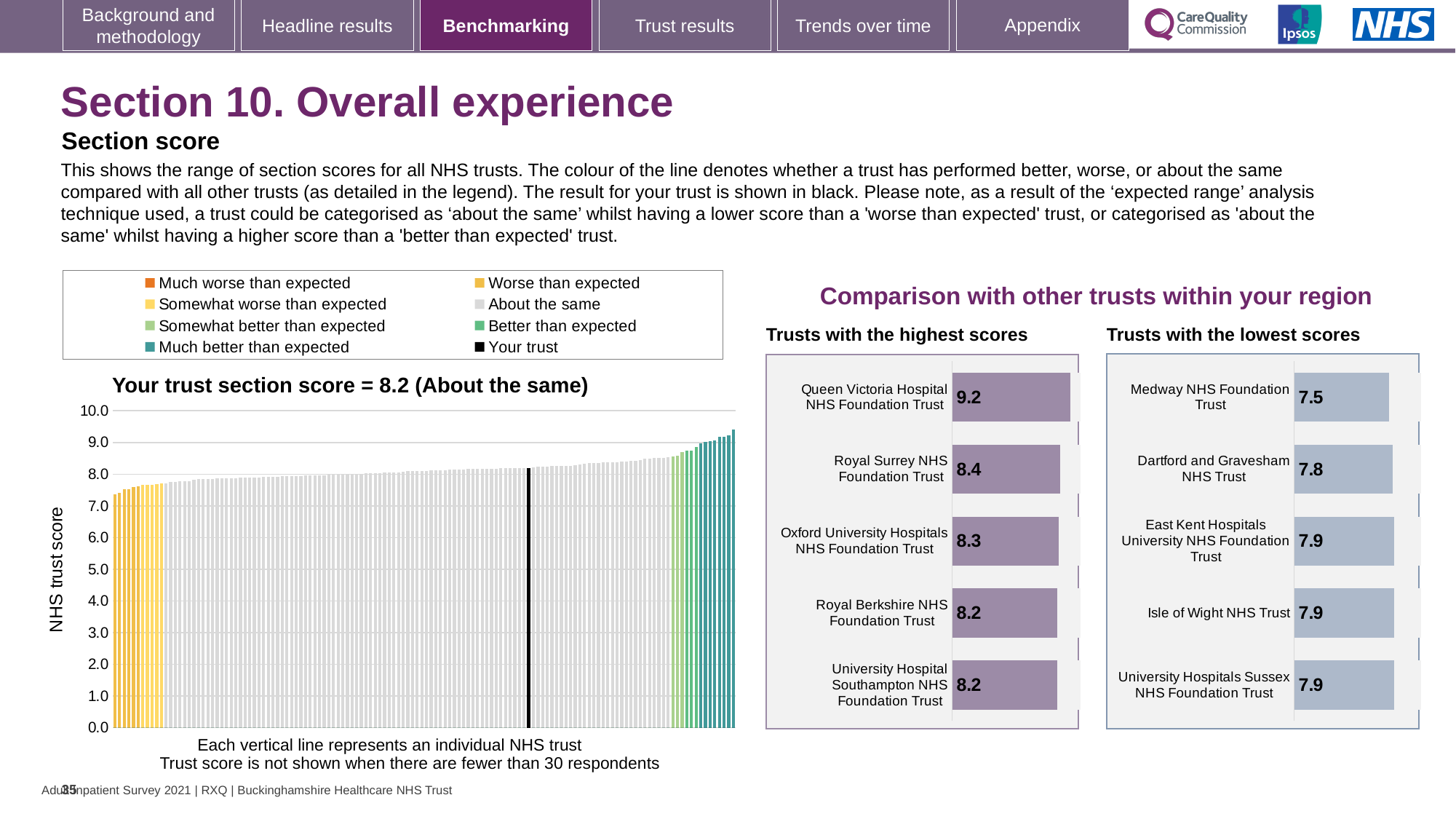
In the 'Trusts with the highest scores' chart, what is the score for Queen Victoria Hospital NHS Foundation Trust? 9.2 What kind of chart is the main chart on the left showing NHS trust scores? Bar chart How many entries does the legend above the main chart on the left list? 8 In the 'Trusts with the lowest scores' chart, which trust has the lowest score? Medway NHS Foundation Trust In the main chart on the left, what is the section score for your trust? 8.2 In the 'Trusts with the highest scores' chart, which trust has the highest score? Queen Victoria Hospital NHS Foundation Trust In the 'Trusts with the highest scores' chart, what is the score for Oxford University Hospitals NHS Foundation Trust? 8.3 In the 'Trusts with the highest scores' chart, what is the difference between the scores of Queen Victoria Hospital NHS Foundation Trust and Royal Surrey NHS Foundation Trust? 0.8 In the 'Trusts with the highest scores' chart, how many trusts are shown? 5 In the 'Trusts with the lowest scores' chart, what is the score for Medway NHS Foundation Trust? 7.5 In the 'Trusts with the lowest scores' chart, what is the difference between the scores of Isle of Wight NHS Trust and Medway NHS Foundation Trust? 0.4 In the 'Trusts with the lowest scores' chart, what is the score for Dartford and Gravesham NHS Trust? 7.8